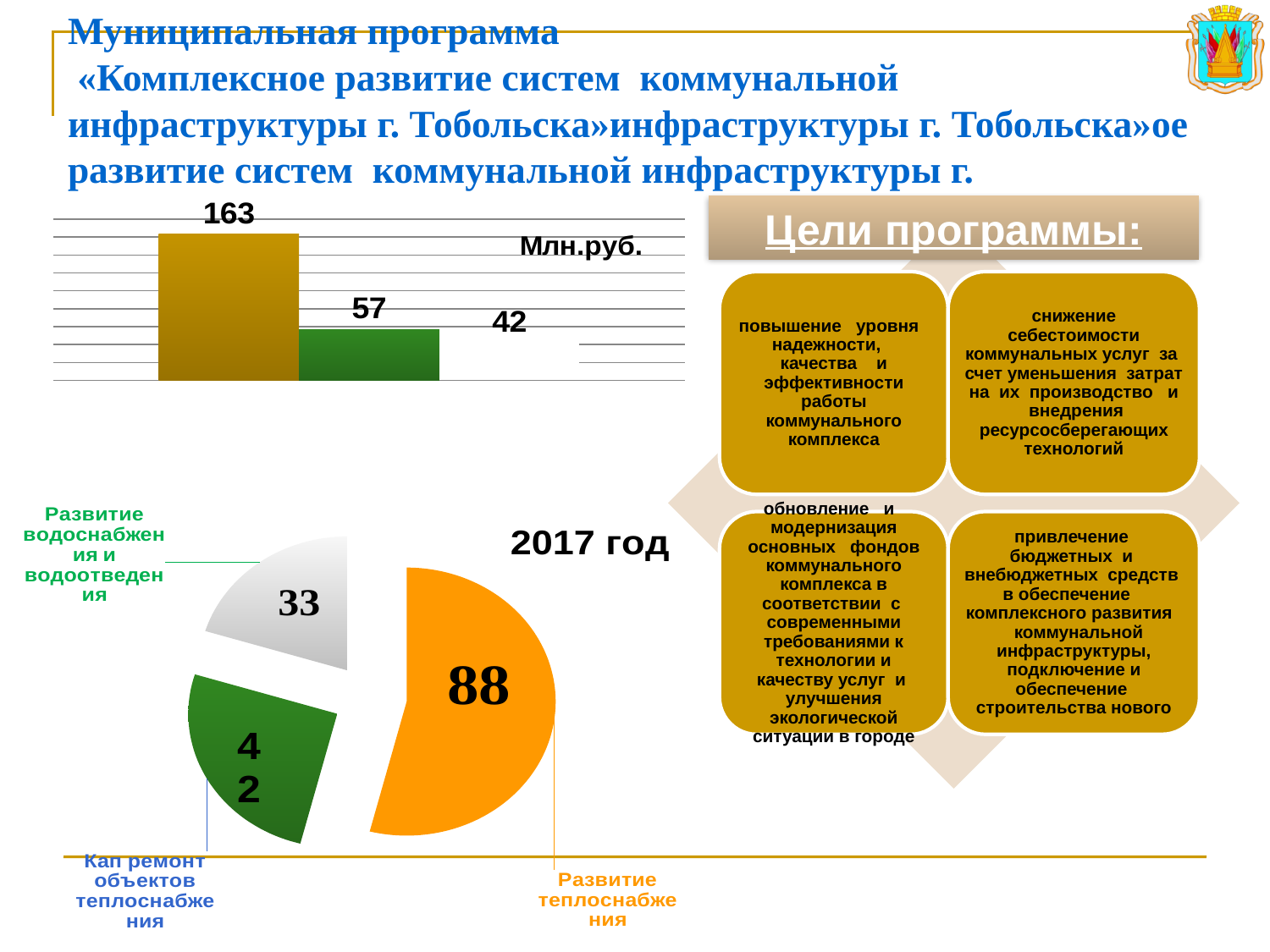
What type of chart is the chart titled "2017 год"? pie chart In the pie chart titled "2017 год", what is the total of all three slices? 163 In the pie chart titled "2017 год", what is the value for "Развитие теплоснабжения"? 88 In the bar chart at the top left, what is the highest value shown? 163 In the bar chart at the top left, what is the lowest value shown? 42 In the bar chart at the top left, what is the difference between the highest value (163) and the lowest value (42)? 121 How many data values are labelled in the bar chart at the top left? 3 In the bar chart at the top left, what unit is indicated next to the chart? Млн.руб. In the pie chart titled "2017 год", which category has the smallest slice? Развитие водоснабжения и водоотведения In the pie chart titled "2017 год", what is the value for "Кап ремонт объектов теплоснабжения"? 42 What type of chart is the chart at the top left of the slide? bar chart In the pie chart titled "2017 год", what is the difference between the values for "Развитие теплоснабжения" and "Развитие водоснабжения и водоотведения"? 55